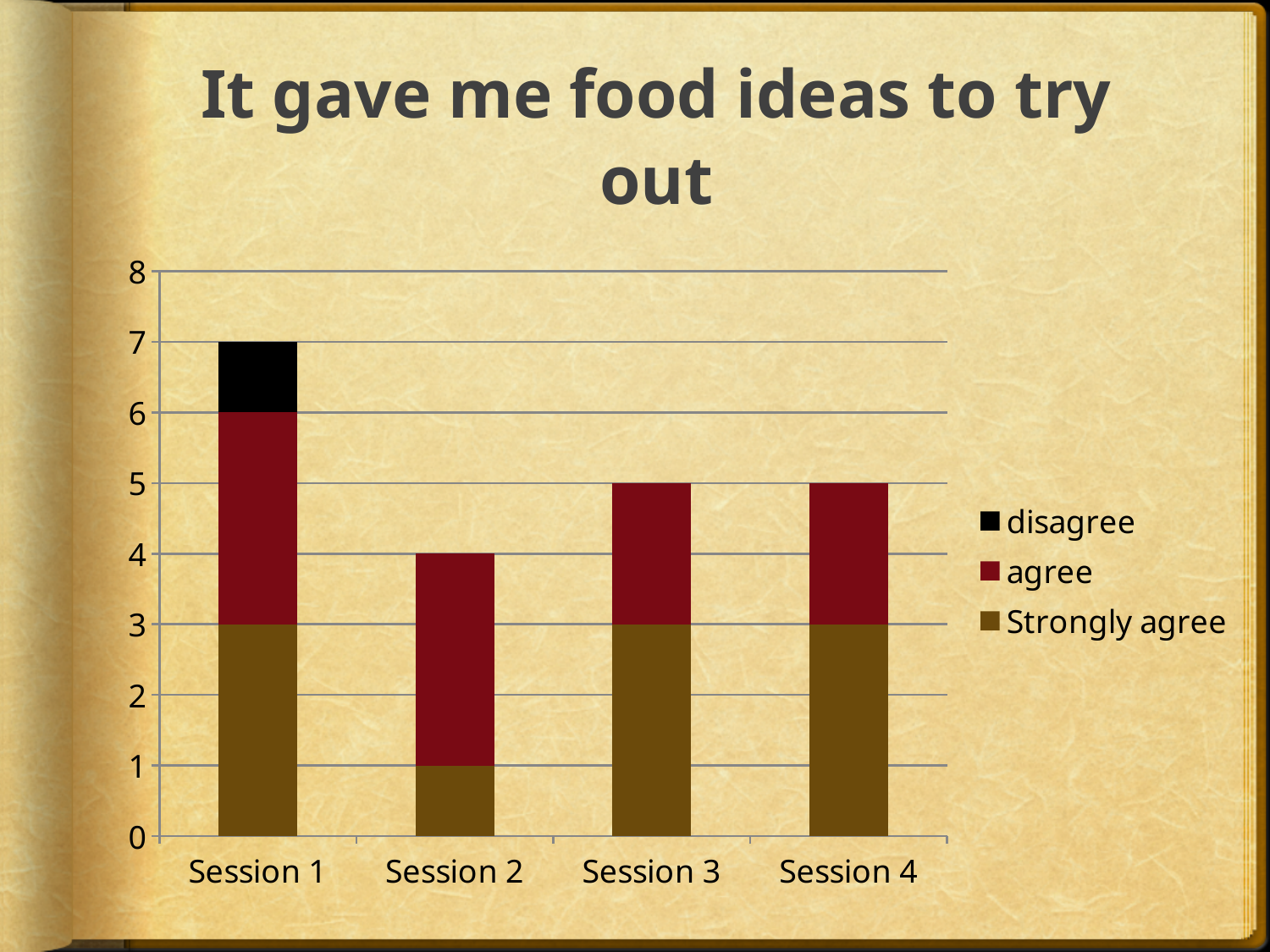
Is the total bar for Session 3 greater or less than 4? greater How many sessions are shown on the x axis? 4 How many series does the legend list? 3 Which session has the lowest total bar? Session 2 What is the Strongly agree value for Session 3? 3 What is the difference between the total bars for Session 1 and Session 2? 3 What is the total height of the stacked bar for Session 1? 7 Which session has the highest total bar? Session 1 What is the total height of the stacked bar for Session 2? 4 Which session is the only one with a disagree segment? Session 1 What kind of chart is shown on the slide? Stacked bar chart What is the Strongly agree value for Session 2? 1